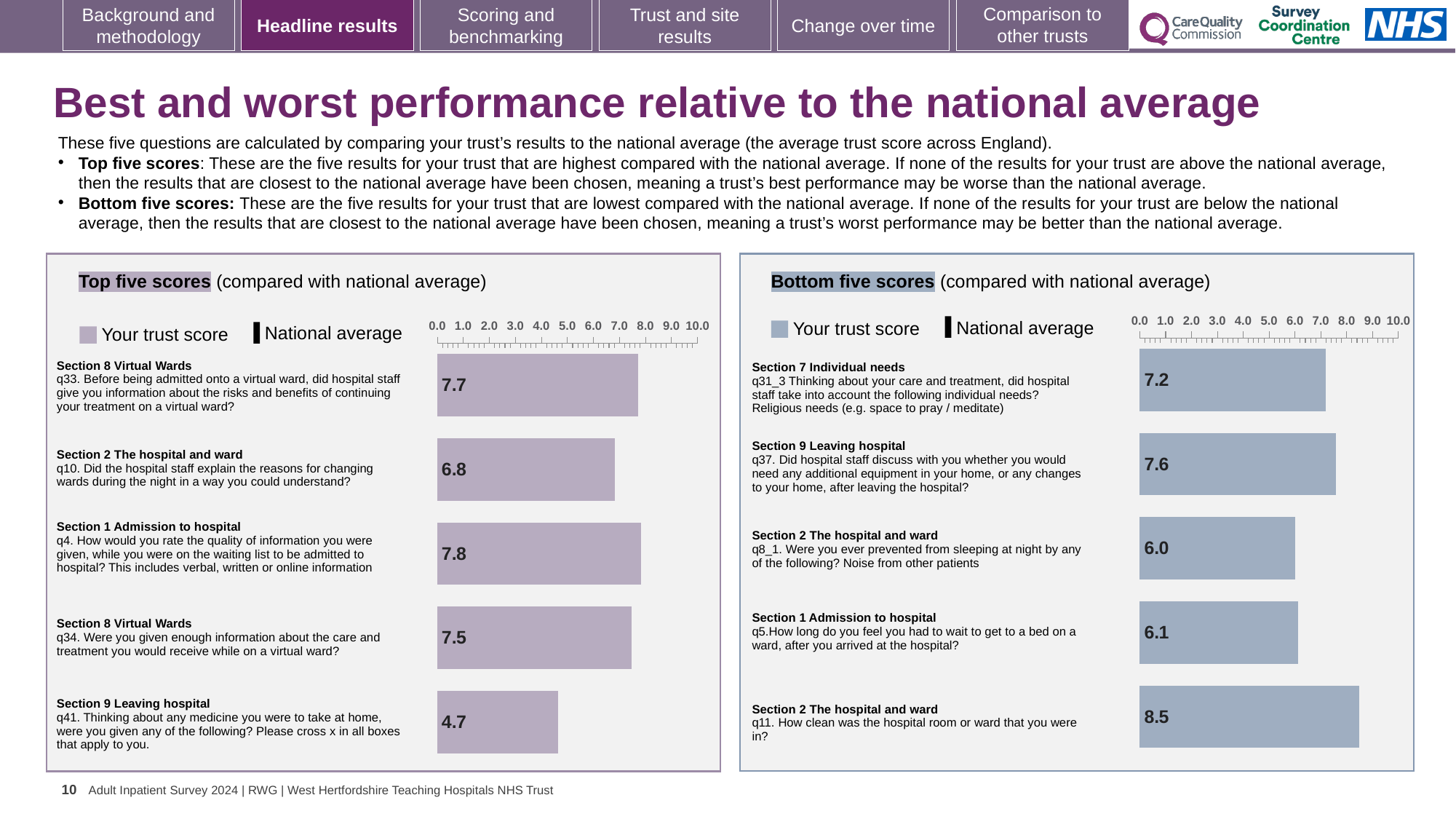
In the Bottom five scores chart, which question has the lowest trust score? q8_1 (Section 2 The hospital and ward) In the Top five scores chart, which question has the highest trust score? q4 (Section 1 Admission to hospital) In the Bottom five scores chart, which is larger: the trust score for q31_3 or for q37? q37 In the Bottom five scores chart, what is the difference between the trust scores for q11 and q5? 2.4 How many questions are plotted in the Top five scores chart? 5 In the Top five scores chart, what is the trust score for q41 (Section 9 Leaving hospital, medicine to take at home)? 4.7 In the Bottom five scores chart, what is the trust score for q11 (how clean was the hospital room or ward)? 8.5 What kind of chart is the Bottom five scores chart? Bar chart In the Bottom five scores chart, what is the trust score for q8_1 (noise from other patients)? 6.0 In the Top five scores chart, what is the difference between the trust scores for q4 and q10? 1.0 In the Top five scores chart, which question has the lowest trust score? q41 (Section 9 Leaving hospital) In the Top five scores chart, what is the trust score for q33 (Section 8 Virtual Wards, information about risks and benefits of a virtual ward)? 7.7